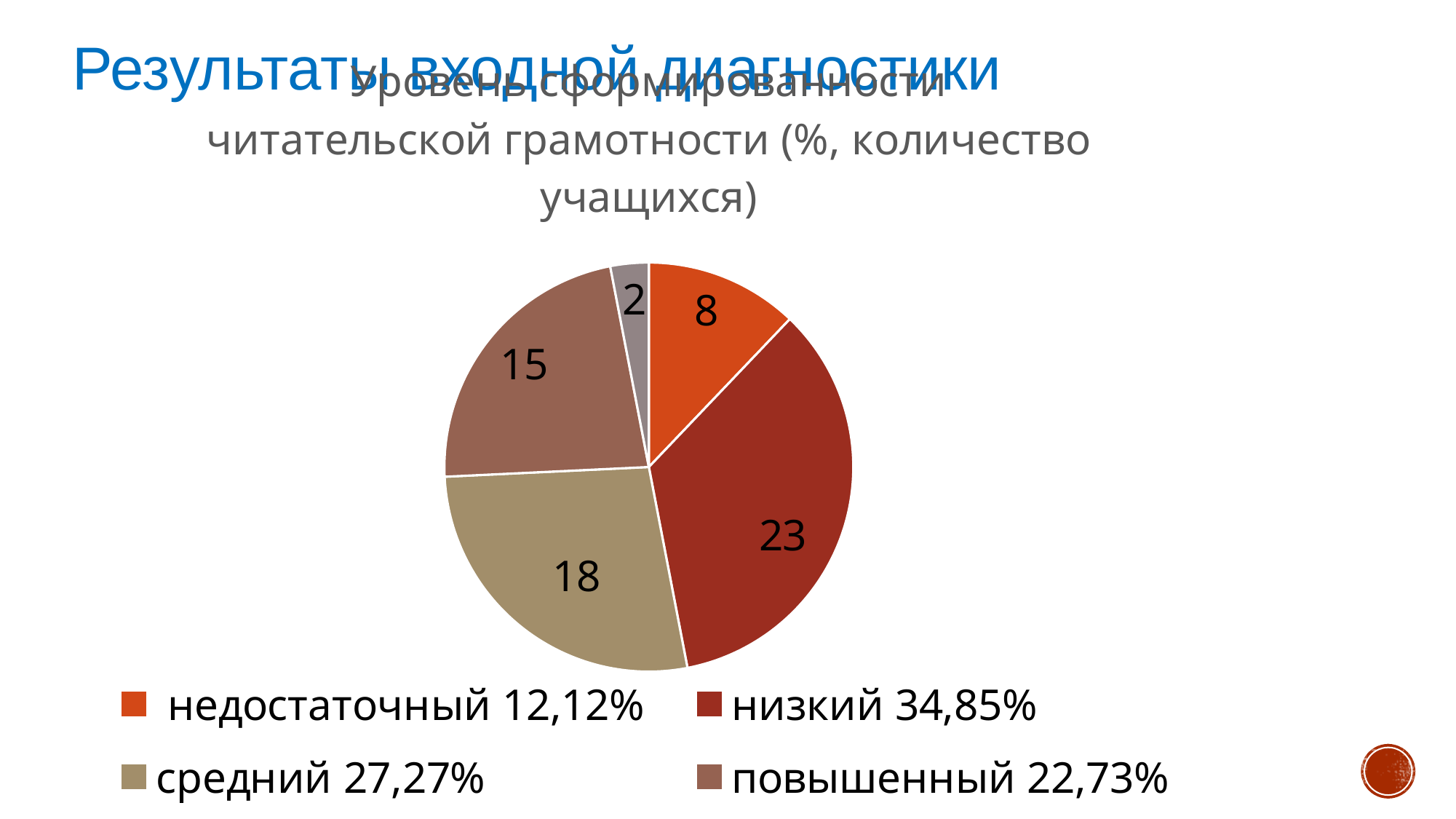
How many slices does the pie chart have? 5 How many students are in the низкий category? 23 Which category has the largest slice of the pie? низкий How many entries does the legend list? 4 What is the smallest value shown on the pie chart? 2 What kind of chart is shown on the slide? pie chart Which is larger, the повышенный value or the недостаточный value? повышенный How many students are in the средний category? 18 What is the difference between the низкий and средний values? 5 How many students are in the недостаточный category? 8 What share of the pie does the недостаточный category represent, according to the legend? 12,12% How many students are in the повышенный category? 15